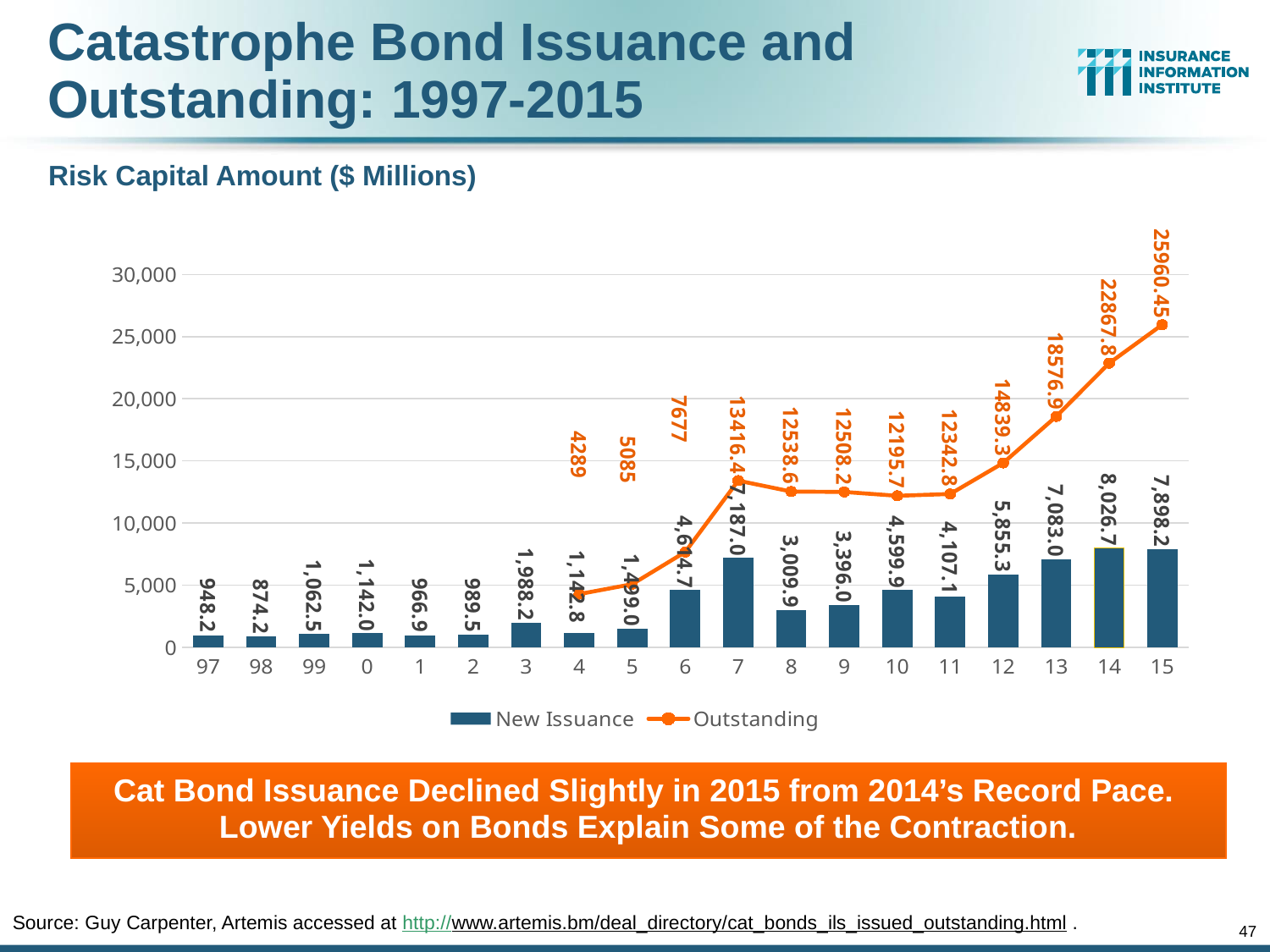
Which is larger, the Outstanding value for 7 or for 8? 7 How many series does the legend list? 2 What is the difference between the New Issuance values for 14 and 15? 128.5 Does the Outstanding line rise or fall from 12 to 15? Rises How many years are shown on the x axis? 19 What is the difference between the Outstanding values for 15 and 14? 3092.65 Which year has the lowest New Issuance value? 98 What is the New Issuance value for 14? 8,026.7 What is the New Issuance value for 7? 7,187.0 What is the Outstanding value for 15? 25960.45 Which year has the highest New Issuance value? 14 What kind of chart is this? Combined bar and line chart